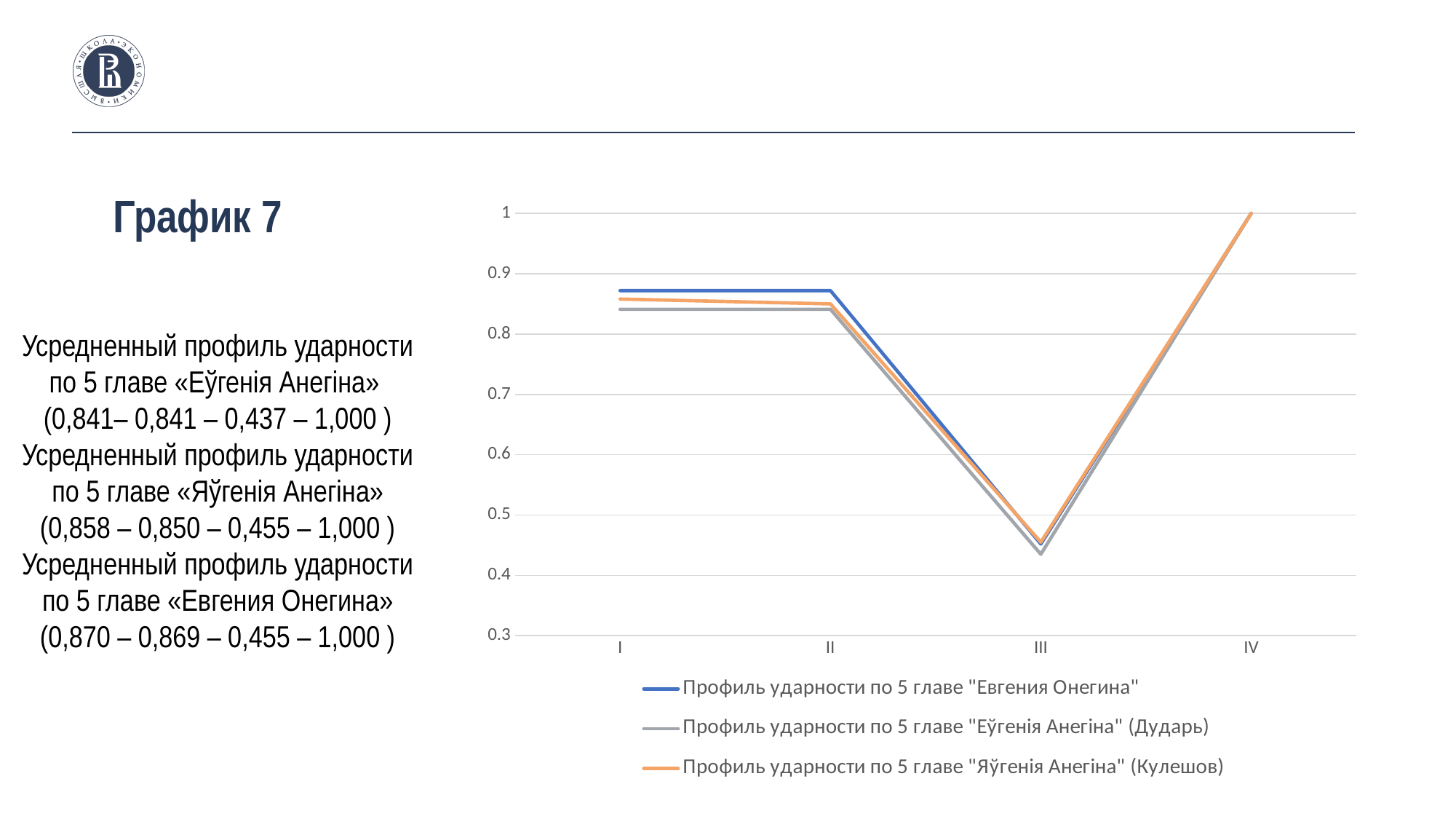
At which x-axis position do all three series reach their highest value? IV What kind of chart is shown on the slide? line chart Is the value of the series "Евгения Онегина" at position III greater or less than 0.5? less What is the title shown to the left of the chart? График 7 Which series has the higher value at position I: "Евгения Онегина" or "Еўгенія Анегіна" (Дударь)? Евгения Онегина According to the text on the slide, what is the value of the averaged stress profile for «Еўгенія Анегіна» at position III? 0,437 Do the values of the series rise or fall from position III to position IV? rise Is the value of the series "Еўгенія Анегіна" (Дударь) at position I greater or less than 0.8? greater How many points are plotted along the x axis for each series? 4 How many series does the chart legend list? 3 At which x-axis position do all three series reach their lowest value? III According to the text on the slide, what is the value of the averaged stress profile for «Евгения Онегина» at position I? 0,870